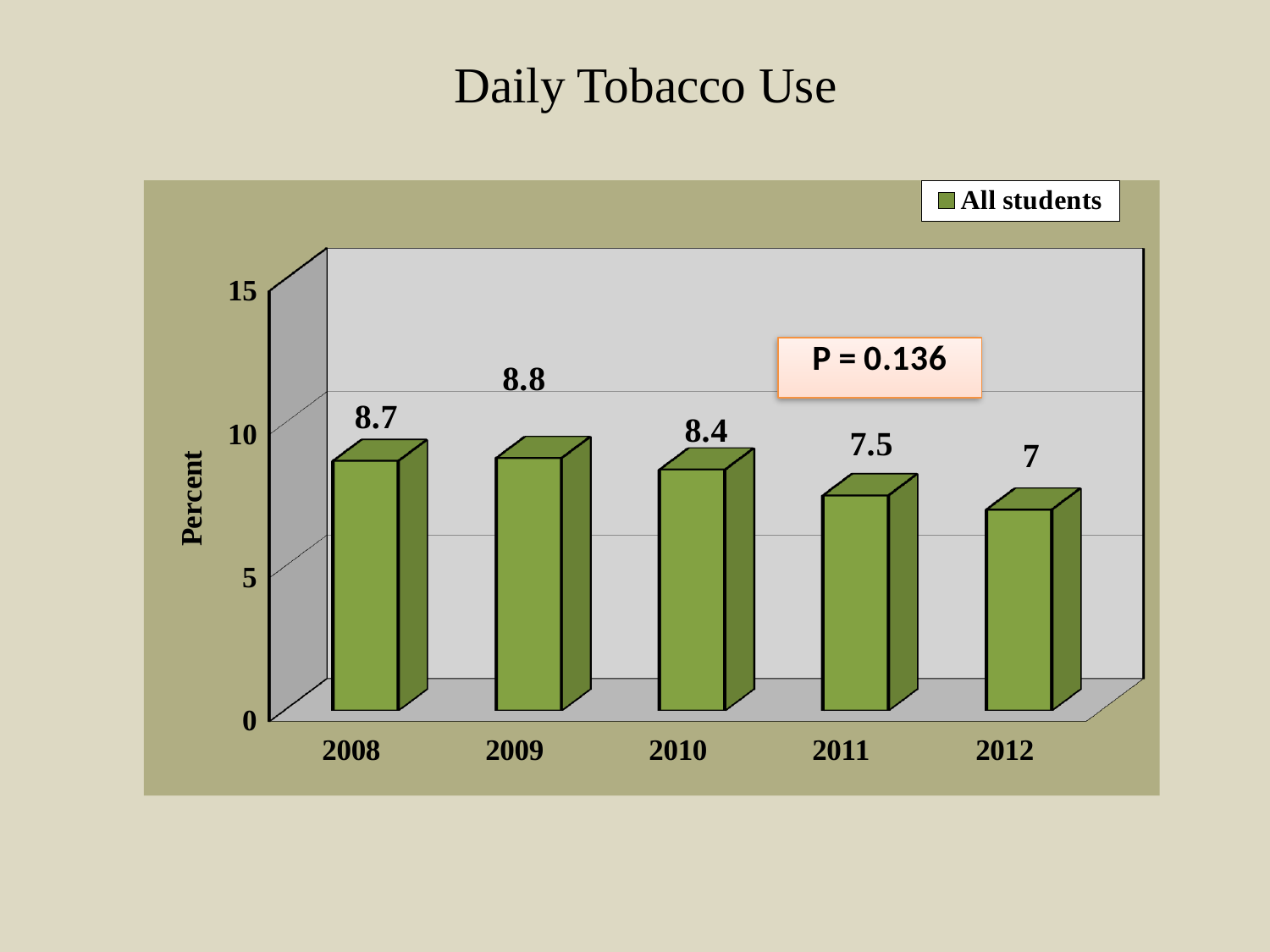
Do the values generally rise or fall from 2009 to 2012? fall What is the value for 2012? 7 How many years are shown on the x axis? 5 What is the difference between the values for 2009 and 2012? 1.8 Which year has the highest value? 2009 Which year has the lowest value? 2012 Which is larger, the value for 2010 or the value for 2011? 2010 What is the value for 2008? 8.7 How many series does the legend list? 1 Is the value for 2011 greater or less than 10? less What is the value for 2010? 8.4 What kind of chart is this? bar chart